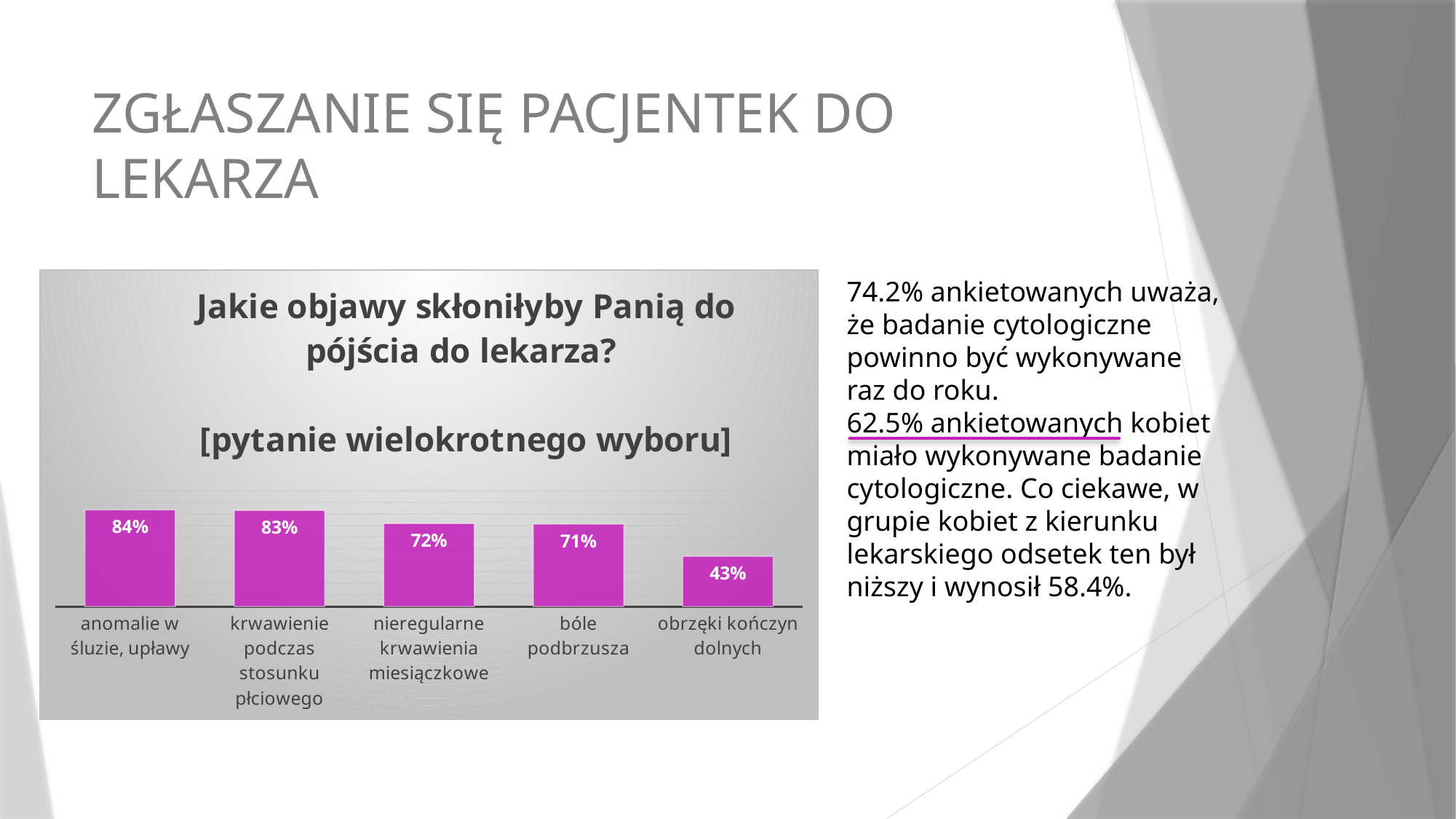
Which is larger: the value for 'nieregularne krwawienia miesiączkowe' or 'obrzęki kończyn dolnych'? nieregularne krwawienia miesiączkowe What is the difference between the values for 'krwawienie podczas stosunku płciowego' and 'bóle podbrzusza'? 12% Which category has the lowest value? obrzęki kończyn dolnych Which category has the highest value? anomalie w śluzie, upławy What is the value for 'nieregularne krwawienia miesiączkowe'? 72% What is the value for 'bóle podbrzusza'? 71% What is the title of the chart? Jakie objawy skłoniłyby Panią do pójścia do lekarza? [pytanie wielokrotnego wyboru] What is the difference between the values for 'anomalie w śluzie, upławy' and 'obrzęki kończyn dolnych'? 41% How many categories are shown in the chart? 5 What is the value for 'obrzęki kończyn dolnych'? 43% What kind of chart is shown on the slide? bar chart What is the value for 'anomalie w śluzie, upławy'? 84%